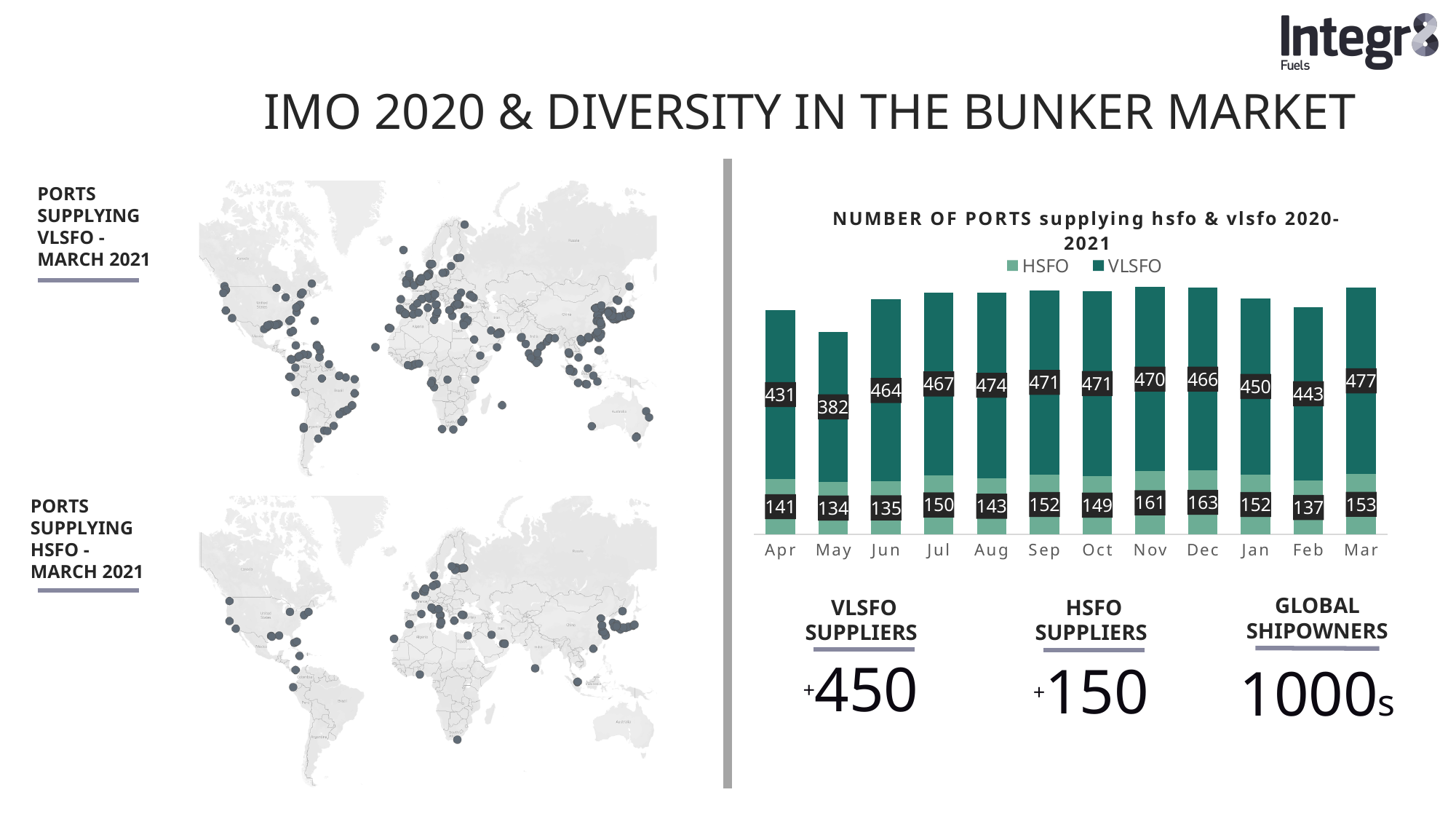
Which is larger in the bar chart: the HSFO value for Nov or the HSFO value for Feb? Nov How many series does the legend of the 'NUMBER OF PORTS supplying hsfo & vlsfo 2020-2021' chart list? 2 What is the difference between the VLSFO values for Mar and May in the bar chart? 95 Which month has the lowest HSFO value in the bar chart? May What type of chart is shown on the right side of the slide? stacked bar chart What is the HSFO value for Dec in the bar chart? 163 In the bar chart, does the VLSFO value rise or fall from Apr to May? fall Which series in the bar chart is shown in the darker green colour? VLSFO What is the VLSFO value for May in the bar chart? 382 What is the total of the stacked bar for Apr in the bar chart? 572 Which month has the highest VLSFO value in the bar chart? Mar How many months are shown on the x axis of the bar chart? 12